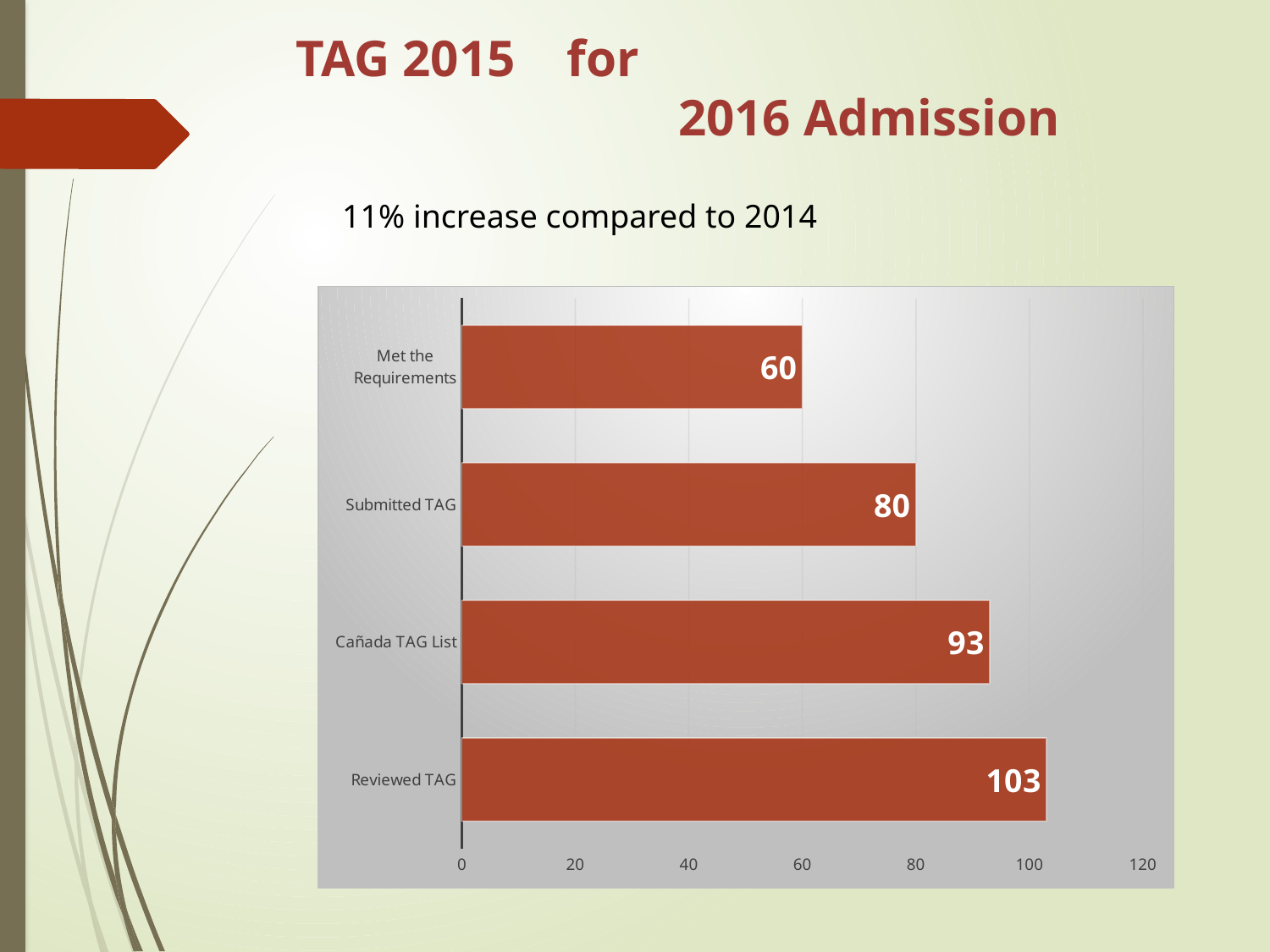
What is the difference between the values for Cañada TAG List and Submitted TAG? 13 Which is larger, the value for Submitted TAG or the value for Met the Requirements? Submitted TAG What is the value for Cañada TAG List? 93 How many categories are shown in the chart? 4 Which category has the highest value? Reviewed TAG Which category has the lowest value? Met the Requirements What is the value for Reviewed TAG? 103 What is the value for Submitted TAG? 80 What is the difference between the values for Reviewed TAG and Met the Requirements? 43 What is the value for Met the Requirements? 60 Is the value for Cañada TAG List greater or less than 100? less What kind of chart is shown on the slide? bar chart